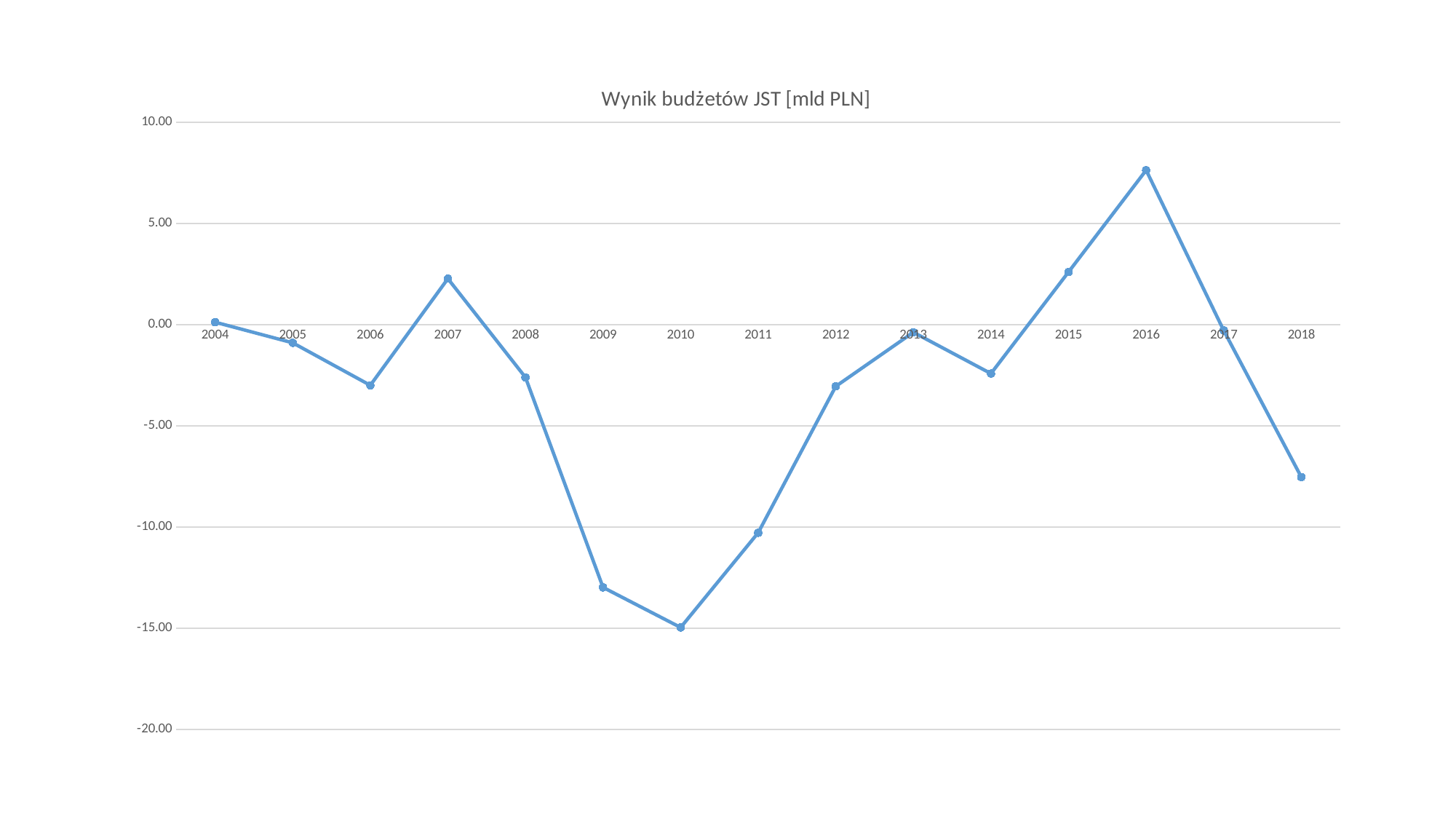
What kind of chart is shown on the slide? line chart Which year has the lowest value? 2010 Is the value for 2009 greater or less than -10.00? less Is the value for 2018 greater or less than -5.00? less Is the value for 2016 greater or less than 5.00? greater Which year has the highest value? 2016 Do the values rise or fall from 2016 to 2018? fall Which year has the larger value, 2011 or 2012? 2012 What is the title of the chart? Wynik budżetów JST [mld PLN] How many years are plotted on the x axis? 15 Which year has the larger value, 2015 or 2014? 2015